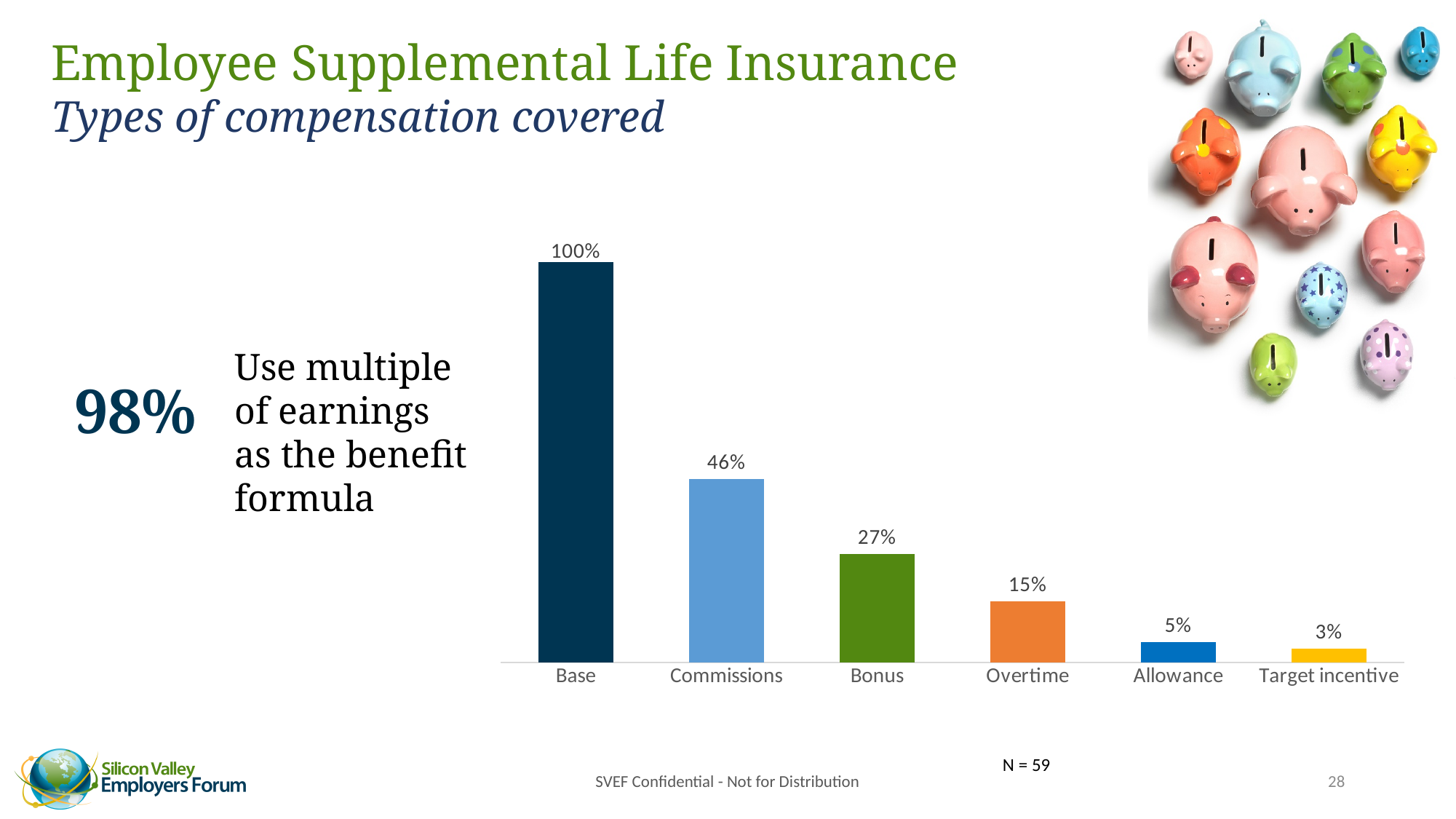
What percentage is shown for Target incentive? 3% Which type of compensation has the highest percentage? Base How many types of compensation are shown in the chart? 6 Which type of compensation has the lowest percentage? Target incentive What percentage is shown for Overtime? 15% What percentage is shown for Base? 100% What is the sample size (N) noted below the chart? N = 59 What percentage is shown for Commissions? 46% Do the values rise or fall from left to right across the categories? Fall What kind of chart is shown on the slide? Bar chart What is the difference between the percentages for Commissions and Bonus? 19% Which is larger, the value for Bonus or the value for Overtime? Bonus